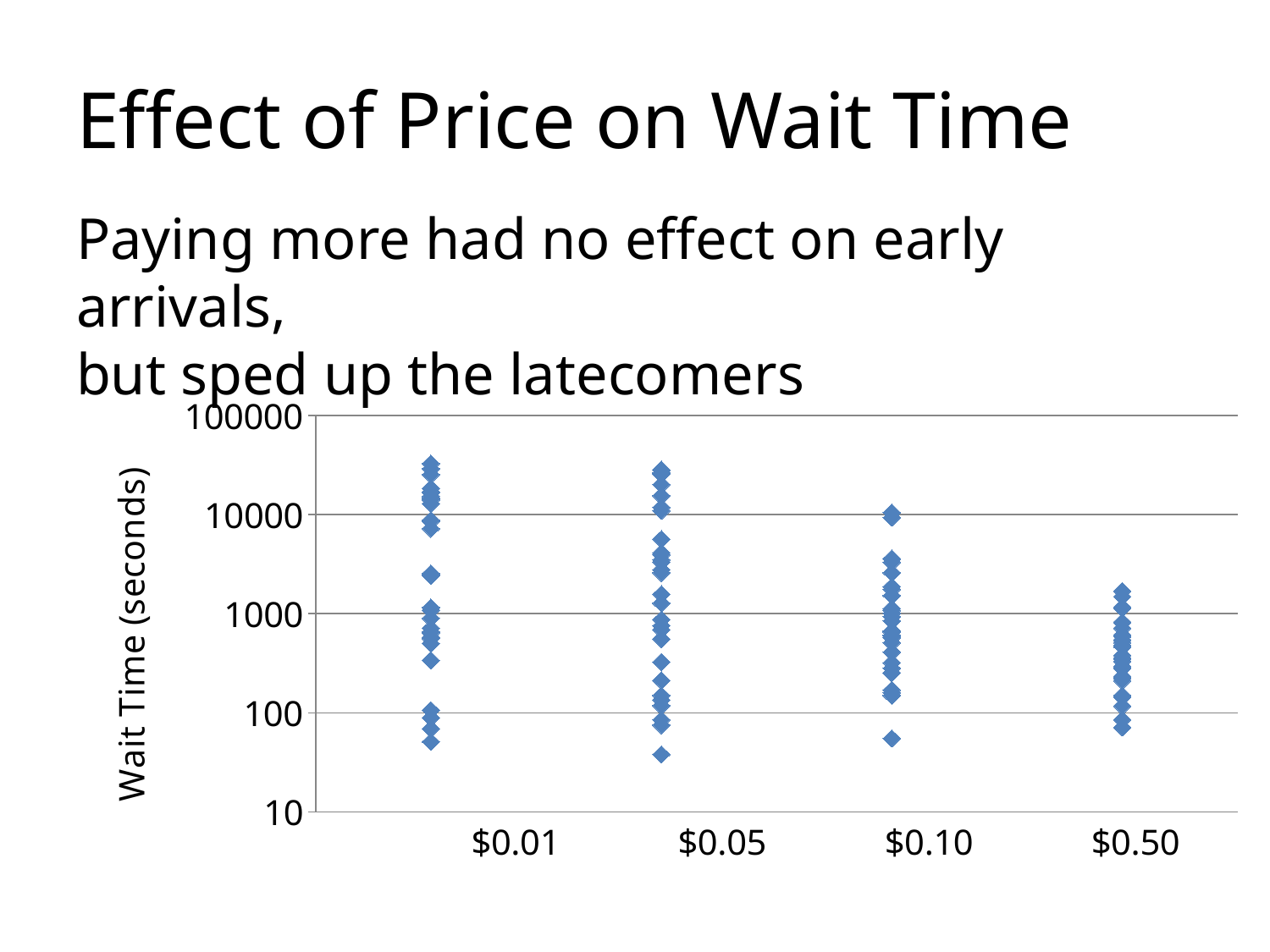
Which is larger, the maximum wait time for $0.05 or for $0.50? $0.05 Which price category has the lowest maximum wait time? $0.50 What is the label of the y axis? Wait Time (seconds) Does the maximum wait time rise or fall as the price increases along the x axis? fall How many price categories are shown on the x axis? 4 Is the highest wait time for $0.01 greater or less than 10000 seconds? greater Is the lowest wait time for $0.01 greater or less than 100 seconds? less Is the lowest wait time for $0.05 greater or less than 100 seconds? less What kind of chart is shown on the slide? scatter chart What is the highest value shown on the y axis? 100000